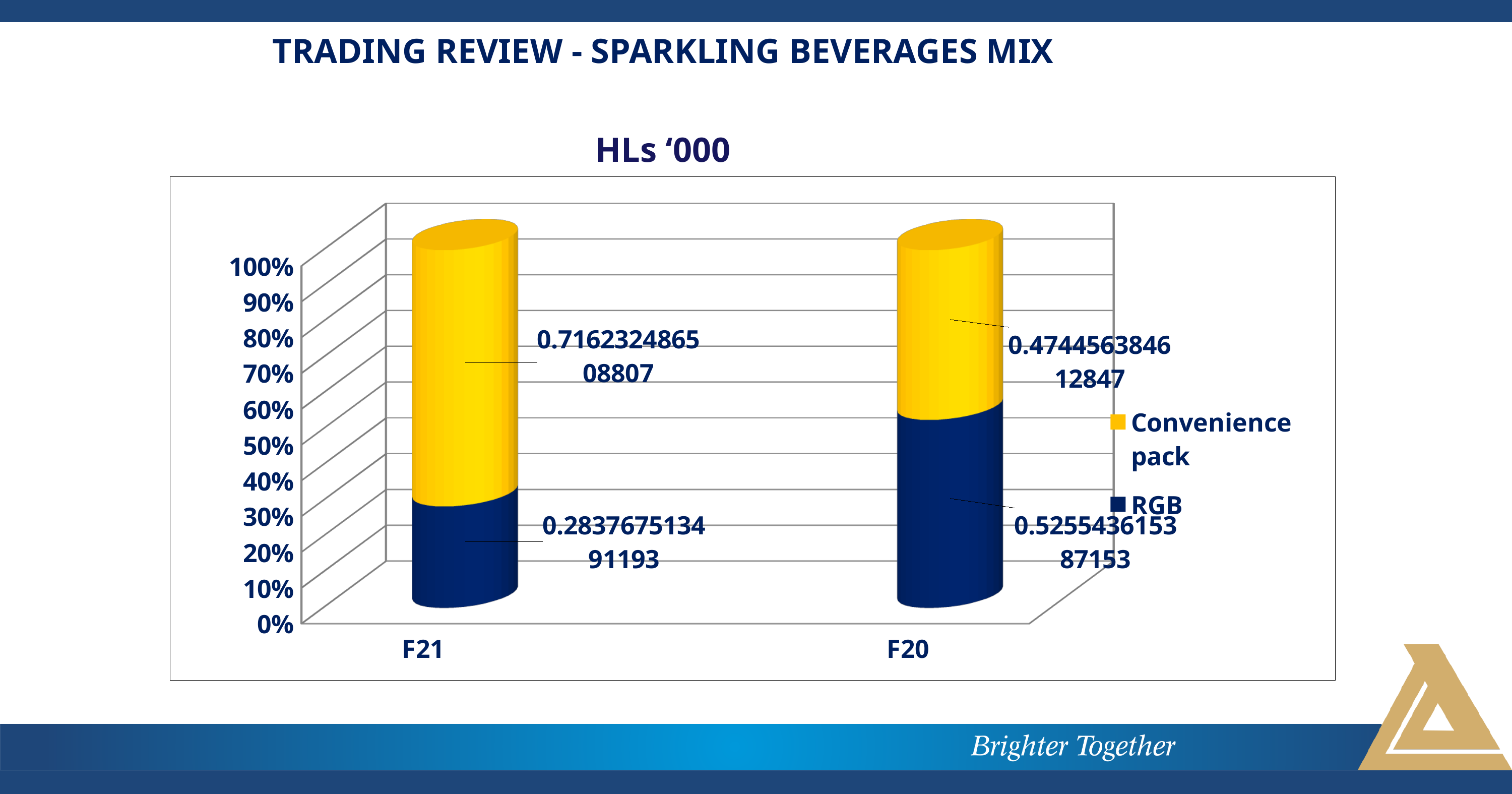
What is the difference between the Convenience pack and RGB values for F21? 0.432464973017614 What is the value of the Convenience pack segment for F20? 0.474456384612847 What kind of chart is shown on the slide? Stacked bar chart Which category has the higher Convenience pack value, F21 or F20? F21 Which category has the lowest RGB value? F21 Does the RGB share rise or fall from F21 to F20? Rise What is the title of the chart? HLs '000 What is the value of the RGB segment for F21? 0.283767513491193 What is the value of the Convenience pack segment for F21? 0.716232486508807 What is the value of the RGB segment for F20? 0.525543615387153 How many series does the legend list? 2 How many categories are shown on the x axis? 2